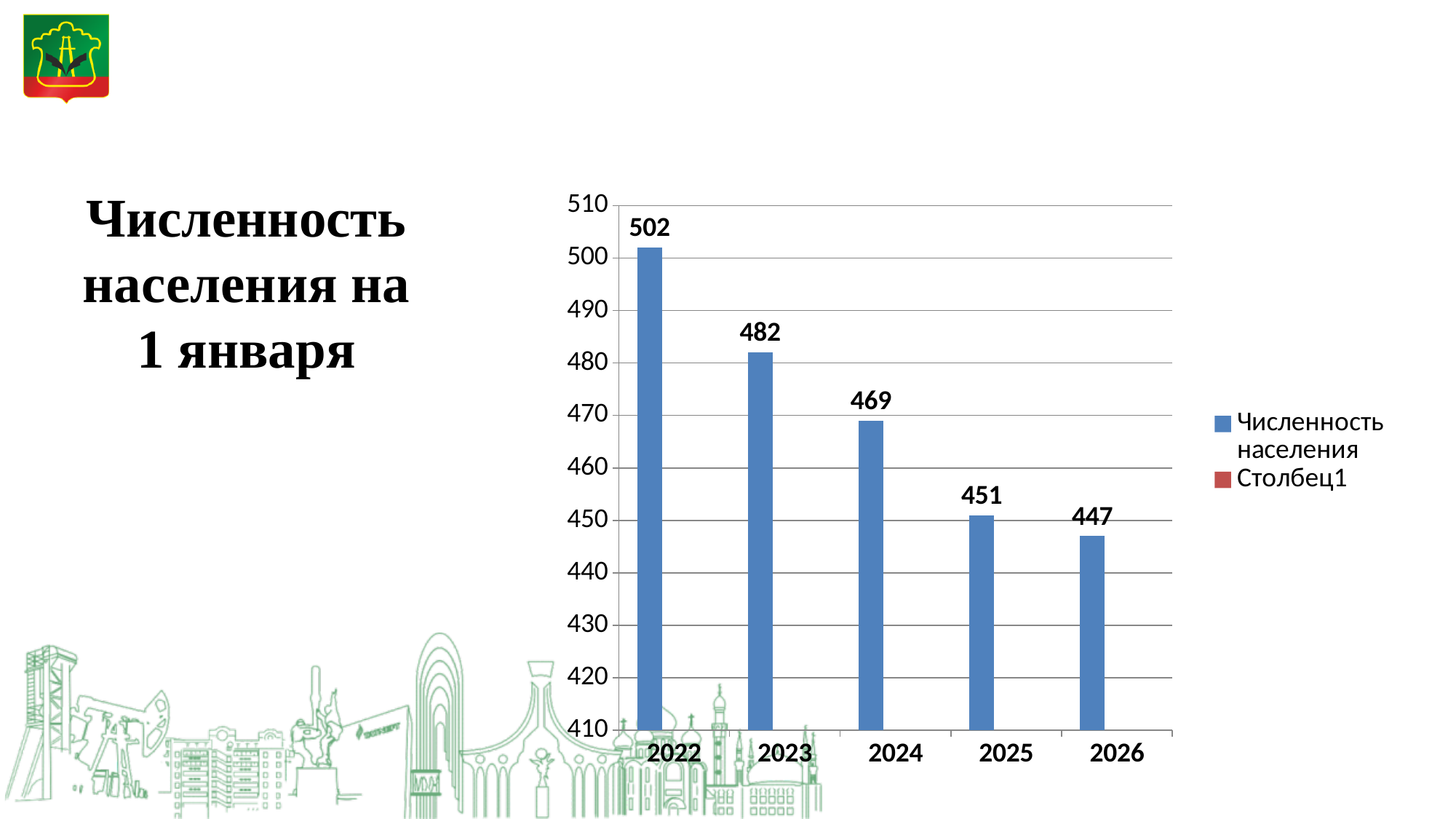
What is the population value shown for 2022? 502 What is the difference between the population values for 2022 and 2023? 20 What kind of chart is shown on the slide? bar chart What is the population value shown for 2024? 469 Which year has the highest population value? 2022 What is the difference between the population values for 2025 and 2026? 4 How many series does the legend list? 2 What is the population value shown for 2026? 447 How many years are shown on the x axis? 5 Do the population values rise or fall from 2022 to 2026? fall Which is larger, the value for 2023 or the value for 2025? 2023 Which year has the lowest population value? 2026